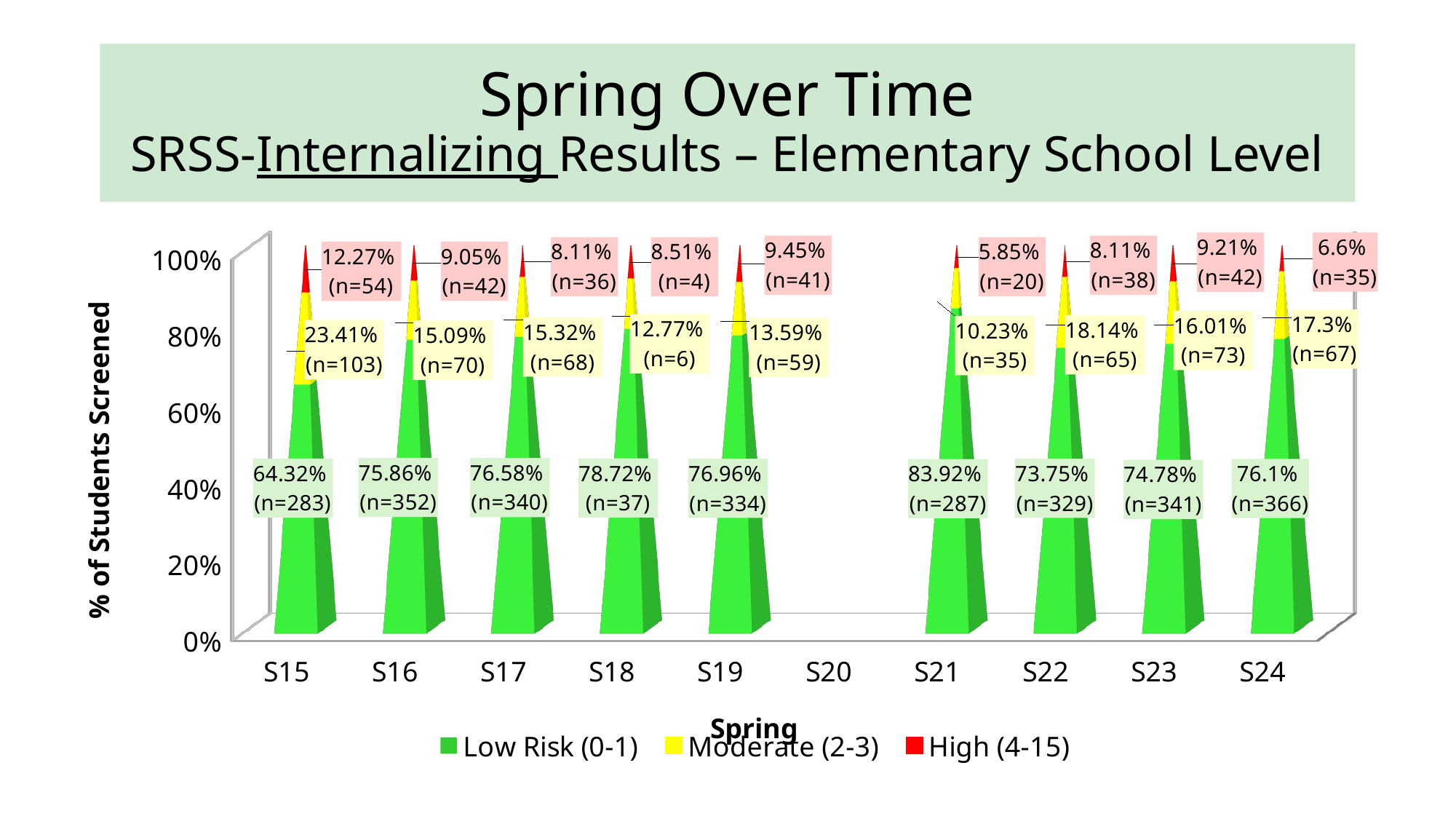
What percentage of students were Low Risk (0-1) in S15? 64.32% Is the Low Risk (0-1) percentage higher in S18 or in S22? S18 What is the difference between the High (4-15) percentage in S15 and in S24? 5.67% How many students were in the Moderate (2-3) group in S22? n=65 Which spring has the lowest Low Risk (0-1) percentage? S15 Which x-axis label has no data plotted? S20 What percentage of students were High (4-15) in S21? 5.85% How many spring labels are shown on the x axis? 10 Which spring has the highest Moderate (2-3) percentage? S15 What kind of chart is shown on the slide? Stacked bar chart Which spring has the highest Low Risk (0-1) percentage? S21 How many series does the legend list? 3